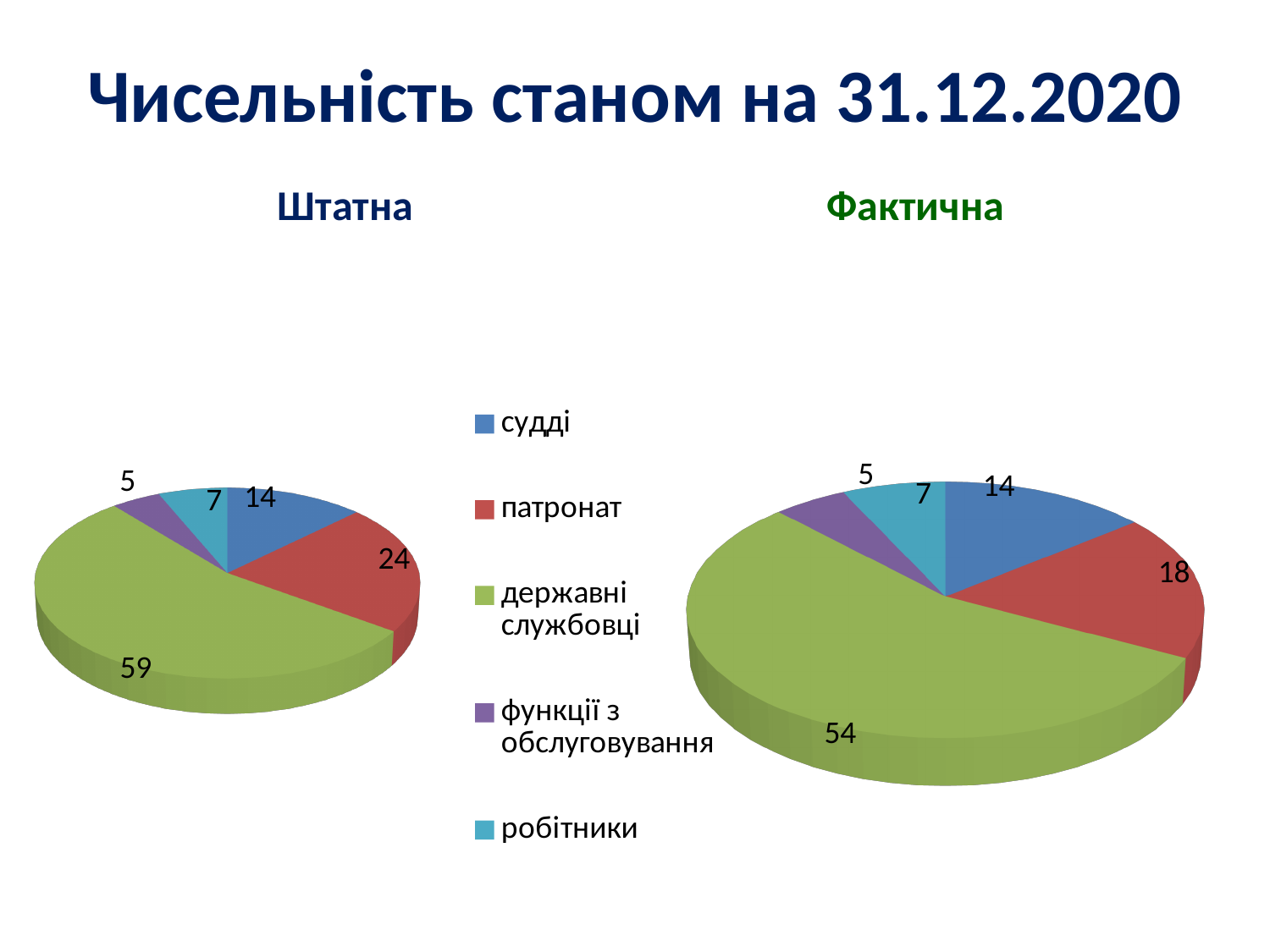
How many entries does the legend list? 5 How many categories does the "Фактична" pie chart have? 5 In the "Фактична" pie chart, what is the value for патронат? 18 What is the total of all slices in the "Фактична" pie chart? 98 In the "Фактична" pie chart, which category has the largest slice? державні службовці In the "Штатна" pie chart, which is larger: судді or патронат? патронат What is the difference between the патронат values in the "Штатна" and "Фактична" pie charts? 6 In the "Штатна" pie chart, which category has the smallest slice? функції з обслуговування What kind of chart is the "Штатна" chart? pie chart In the "Штатна" pie chart, what is the value for робітники? 7 What is the title of the slide? Чисельність станом на 31.12.2020 In the "Штатна" pie chart, what is the value for державні службовці? 59